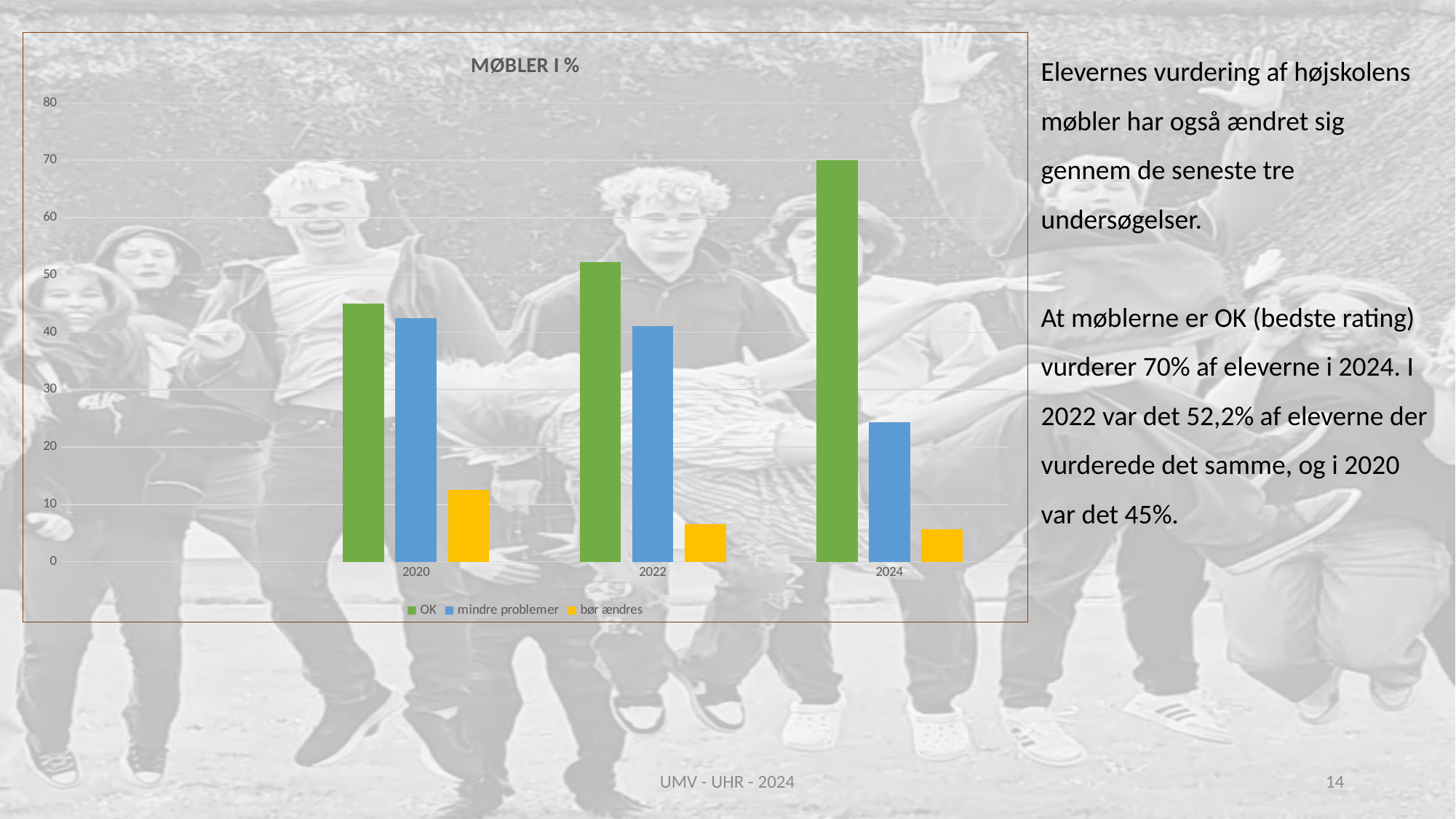
What is the value for OK in 2022? 52,2% How many series does the chart legend list? 3 Is the value for mindre problemer in 2024 greater or less than 30? less Does the OK value rise or fall from 2020 to 2024? rise Is the value for bør ændres in 2020 greater or less than 10? greater What is the value for OK in 2020? 45% How many years (categories) are shown on the x axis of the chart? 3 In which year is the OK value highest? 2024 How much higher is the OK value in 2024 than in 2020? 25 percentage points What type of chart is shown on the slide? bar chart What is the title of the chart? MØBLER I % What is the value for OK in 2024? 70%